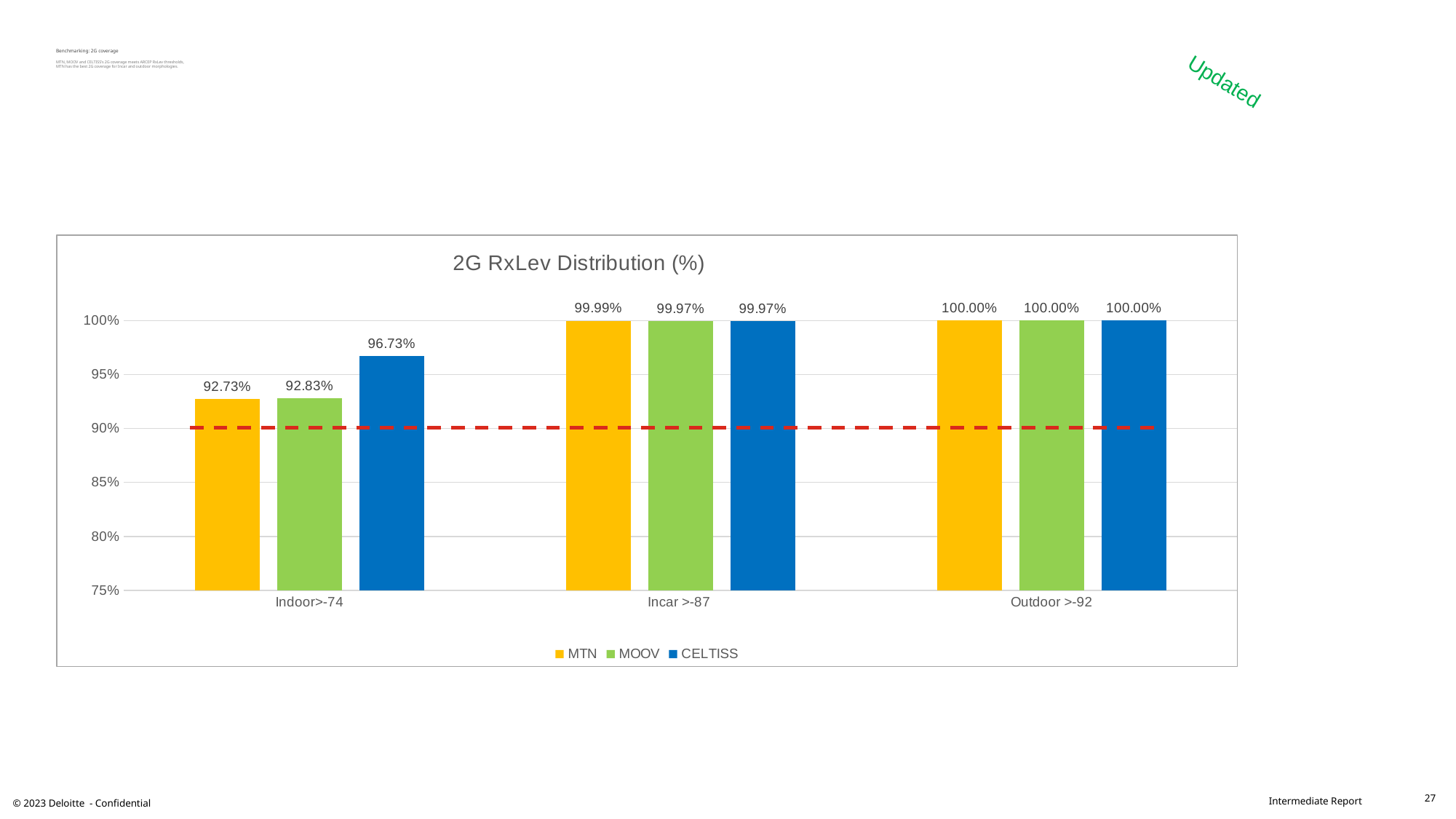
What is the value for MOOV in the Indoor>-74 category? 92.83% Which series has the highest value in the Indoor>-74 category? CELTISS What is the value for CELTISS in the Indoor>-74 category? 96.73% How many series does the legend list? 3 What is the value for MTN in the Incar >-87 category? 99.99% Do the MTN values rise or fall from Indoor>-74 to Outdoor >-92? rise Is the MTN value in the Indoor>-74 category greater or less than 90%? greater Which category has the lowest value for MTN? Indoor>-74 What is the title of the chart? 2G RxLev Distribution (%) What is the difference between the CELTISS and MTN values in the Indoor>-74 category? 4.00% What kind of chart is shown? bar chart How many categories are shown on the x axis? 3